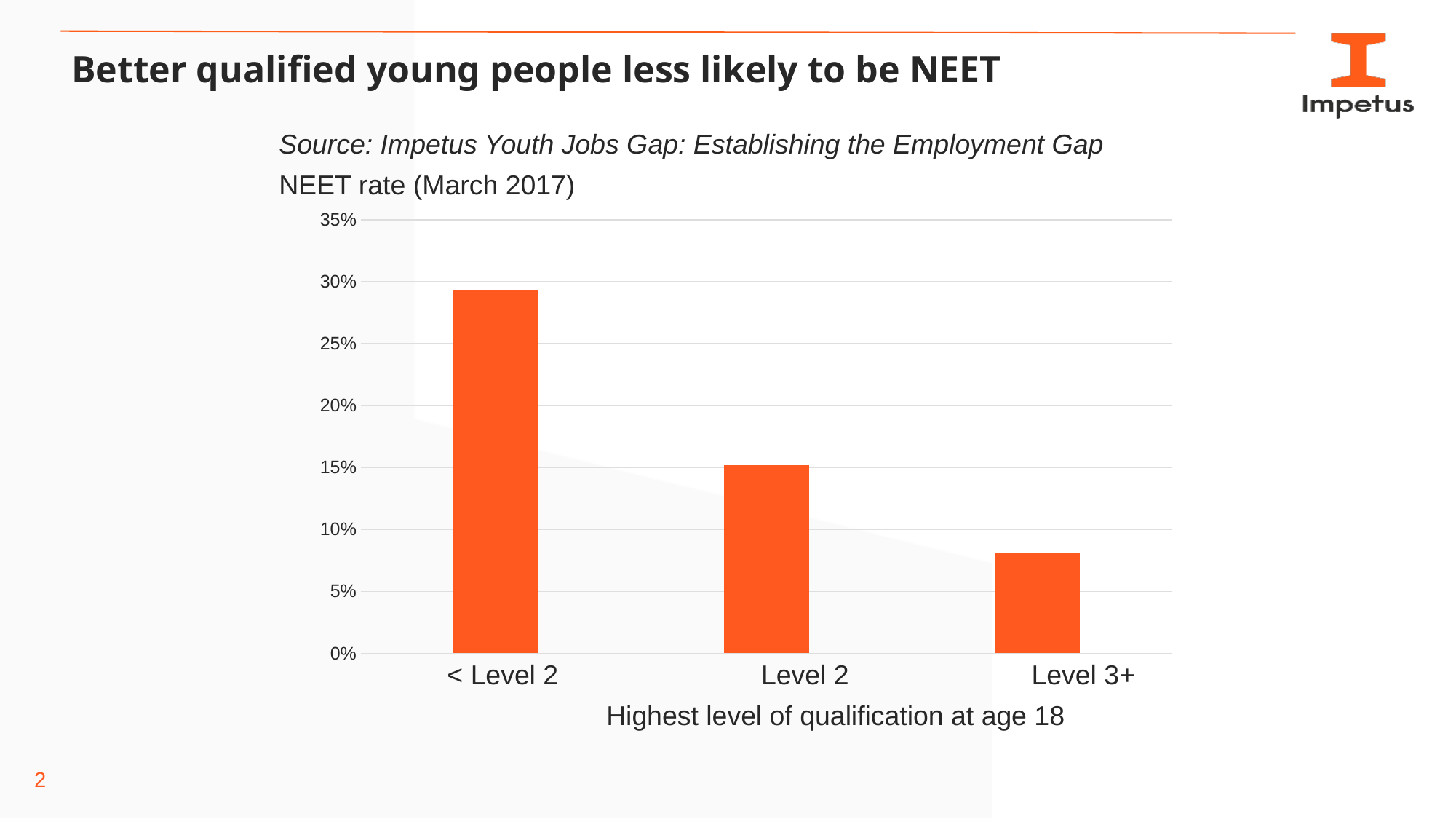
Is the NEET rate for < Level 2 greater or less than 30%? less Do the NEET rates rise or fall as the qualification level increases along the x axis? fall How many qualification categories are plotted on the chart? 3 What is the label of the x axis on the chart? Highest level of qualification at age 18 Is the NEET rate for Level 3+ greater or less than 10%? less Which qualification level has the highest NEET rate? < Level 2 Which has a higher NEET rate, Level 2 or Level 3+? Level 2 What kind of chart is shown on the slide? bar chart Is the NEET rate for Level 3+ greater or less than 5%? greater Which qualification level has the lowest NEET rate? Level 3+